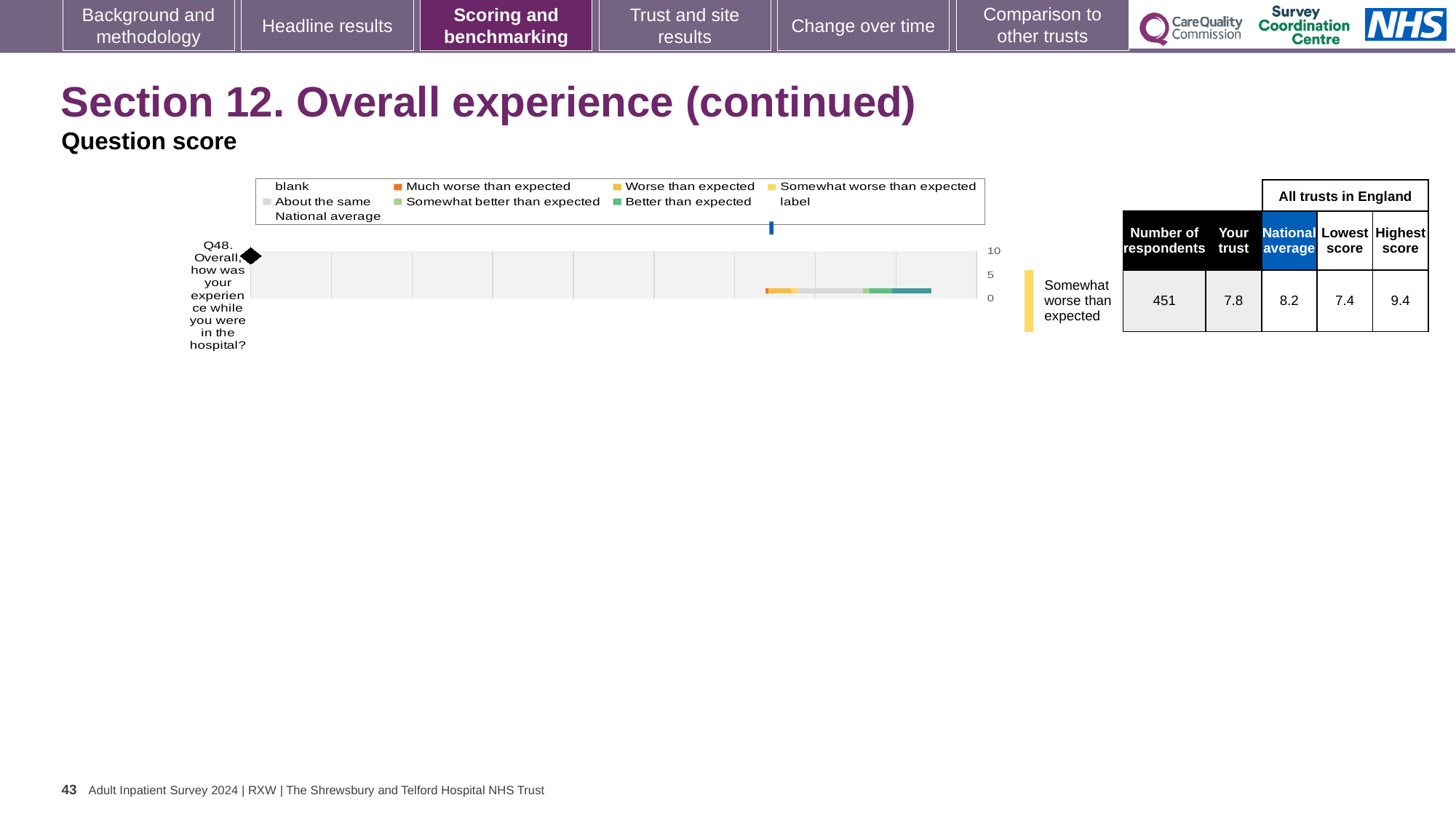
What benchmark category is the trust's Q48 result labelled as next to the chart? Somewhat worse than expected According to the table, what is the lowest score among all trusts in England for Q48? 7.4 Which legend entry is shown in orange? Much worse than expected What is the difference between the national average (8.2) and the 'Your trust' score (7.8) for Q48? 0.4 According to the table next to the chart, what is the national average score for Q48? 8.2 What kind of chart is shown on the slide for Q48? bar chart According to the table next to the chart, what is the 'Your trust' score for Q48? 7.8 According to the table, what is the highest score among all trusts in England for Q48? 9.4 How many respondents answered Q48, according to the table? 451 Which is larger for Q48: the 'Your trust' score or the national average? National average How many survey questions are plotted in the chart? 1 What is the difference between the highest score (9.4) and the lowest score (7.4) for Q48? 2.0